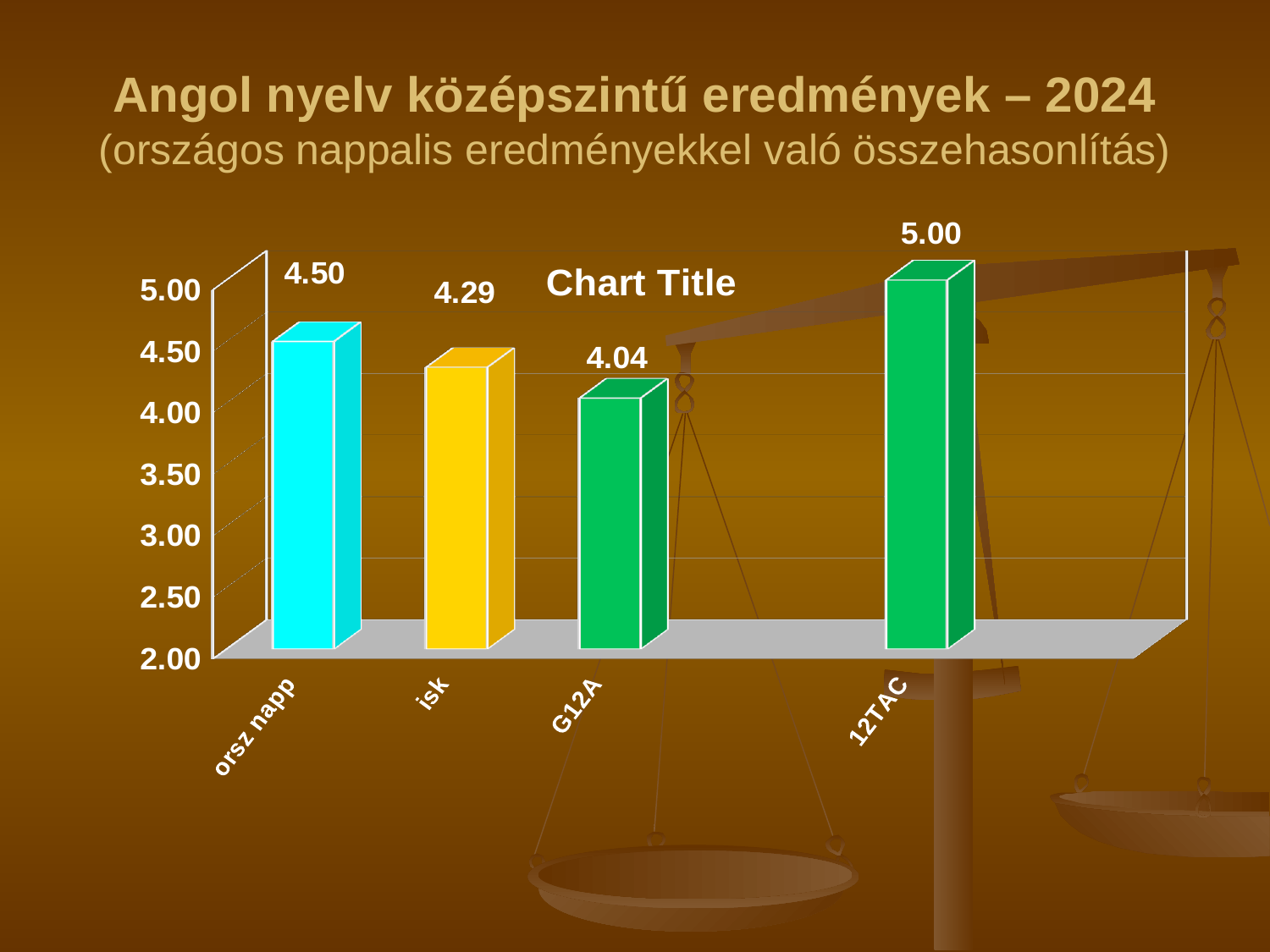
What is the value for isk? 4.29 What is the difference between the values for 12TAC and G12A? 0.96 What is the difference between the values for orsz napp and isk? 0.21 What kind of chart is shown on the slide? bar chart How many categories are shown on the chart? 4 Which category has the lowest value? G12A What is the value for 12TAC? 5.00 What is the value for orsz napp? 4.50 What is the value for G12A? 4.04 What is the title printed on the chart itself? Chart Title Which category has the highest value? 12TAC Which is larger, the value for isk or the value for G12A? isk